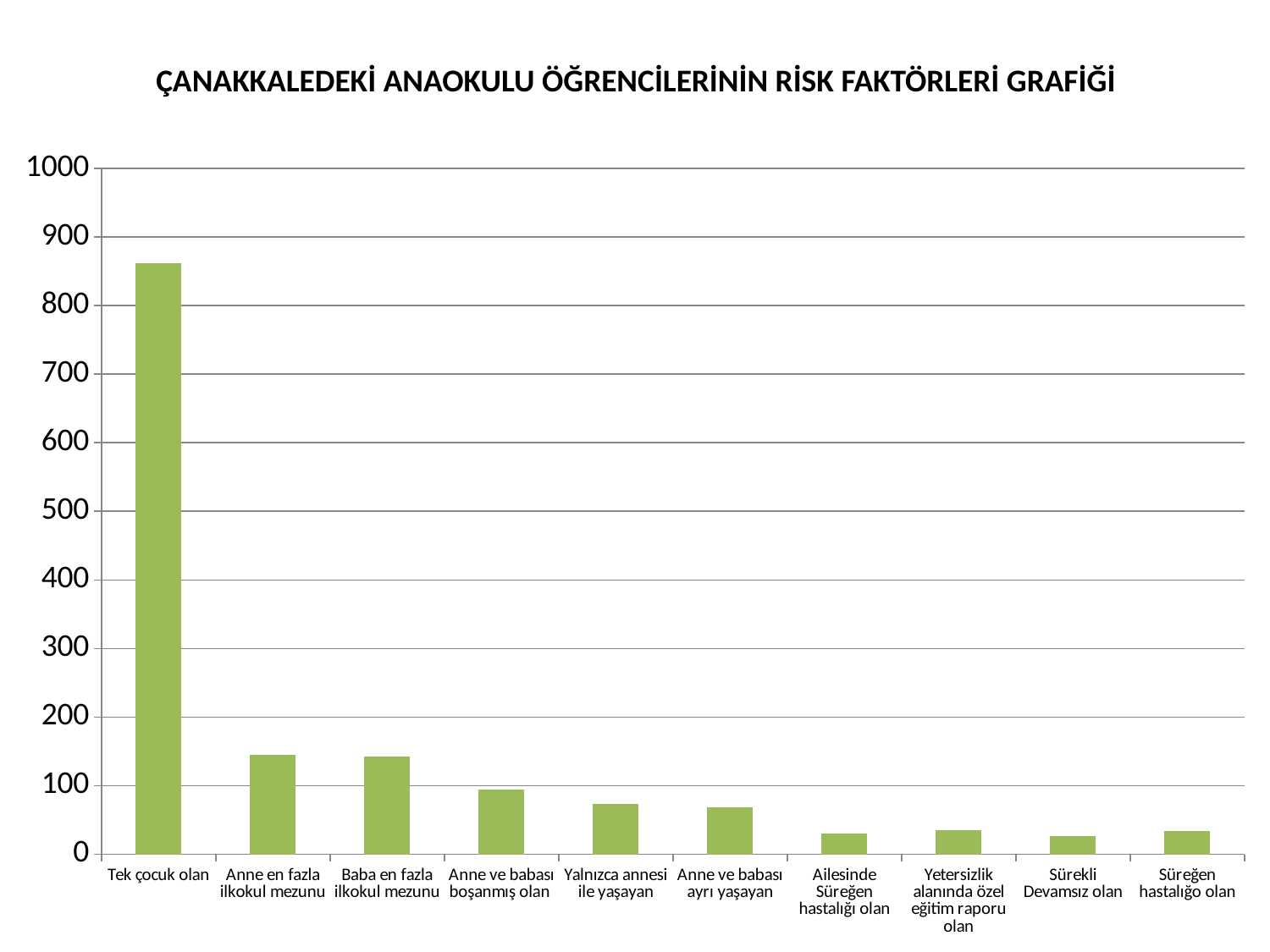
Which is larger, the value for Tek çocuk olan or the value for Baba en fazla ilkokul mezunu? Tek çocuk olan How many categories are shown on the x axis of the chart? 10 Is the value for Tek çocuk olan greater or less than 800? greater Is the value for Yalnızca annesi ile yaşayan greater or less than 100? less What is the maximum value shown on the y axis of the chart? 1000 What kind of chart is shown on the slide? bar chart What is the title of the chart? ÇANAKKALEDEKİ ANAOKULU ÖĞRENCİLERİNİN RİSK FAKTÖRLERİ GRAFİĞİ Which is larger, the value for Anne ve babası boşanmış olan or the value for Yalnızca annesi ile yaşayan? Anne ve babası boşanmış olan Is the value for Ailesinde Süreğen hastalığı olan greater or less than 100? less Which category has the highest value in the chart? Tek çocuk olan